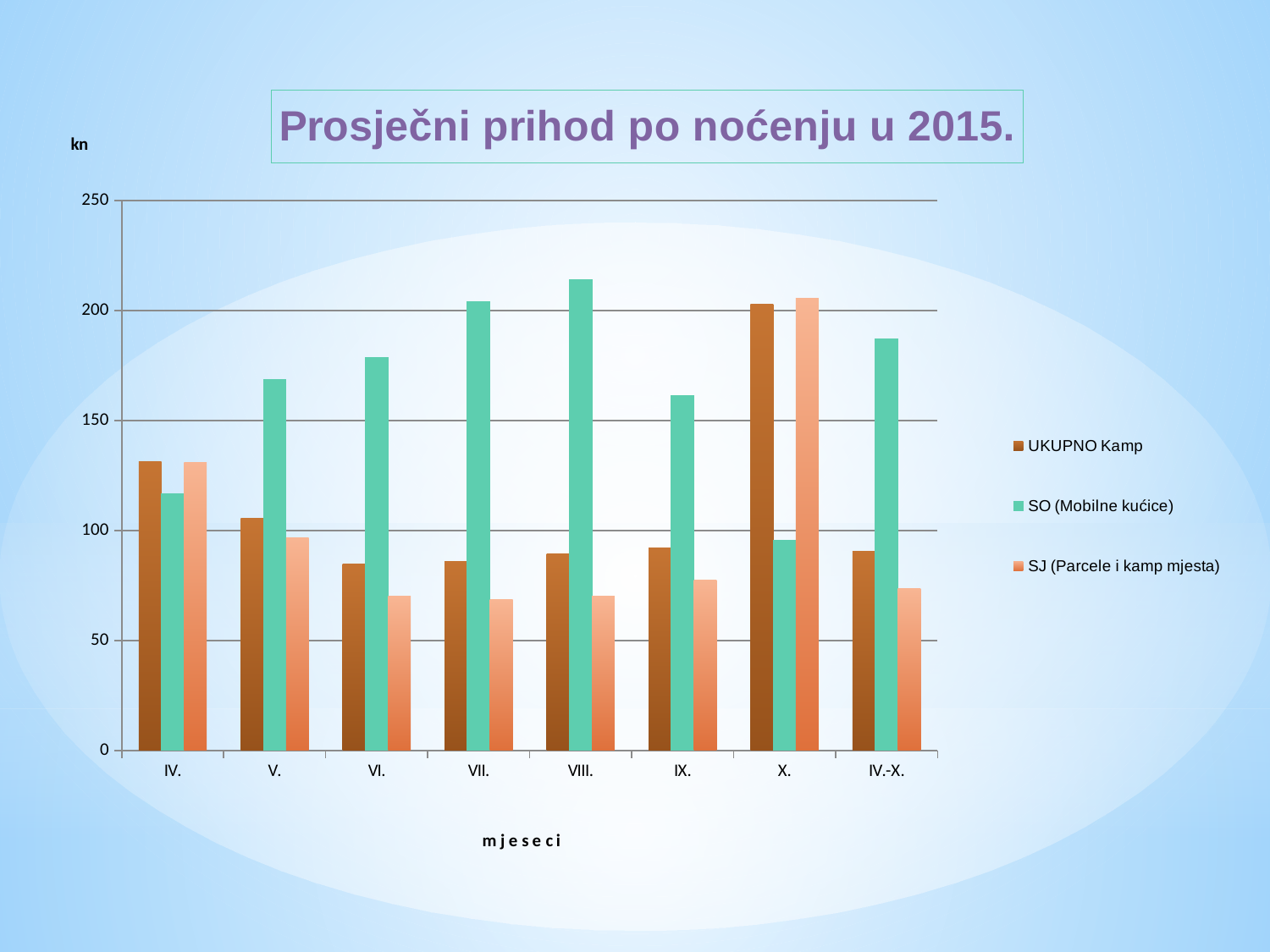
Is the value for SJ (Parcele i kamp mjesta) in VI. greater or less than 100? less Does the value for SO (Mobilne kućice) rise or fall from IV. to VIII.? rise What kind of chart is shown on the slide? bar chart How many categories are shown on the x axis? 8 In which category is the value for SJ (Parcele i kamp mjesta) highest? X. How many series does the legend list? 3 In X., which is larger: SJ (Parcele i kamp mjesta) or SO (Mobilne kućice)? SJ (Parcele i kamp mjesta) What is the title of the chart? Prosječni prihod po noćenju u 2015. What is the label of the x axis? mjeseci In which month is the value for SO (Mobilne kućice) lowest? X. Is the value for SO (Mobilne kućice) in VIII. greater or less than 200? greater In which month is the value for SO (Mobilne kućice) highest? VIII.